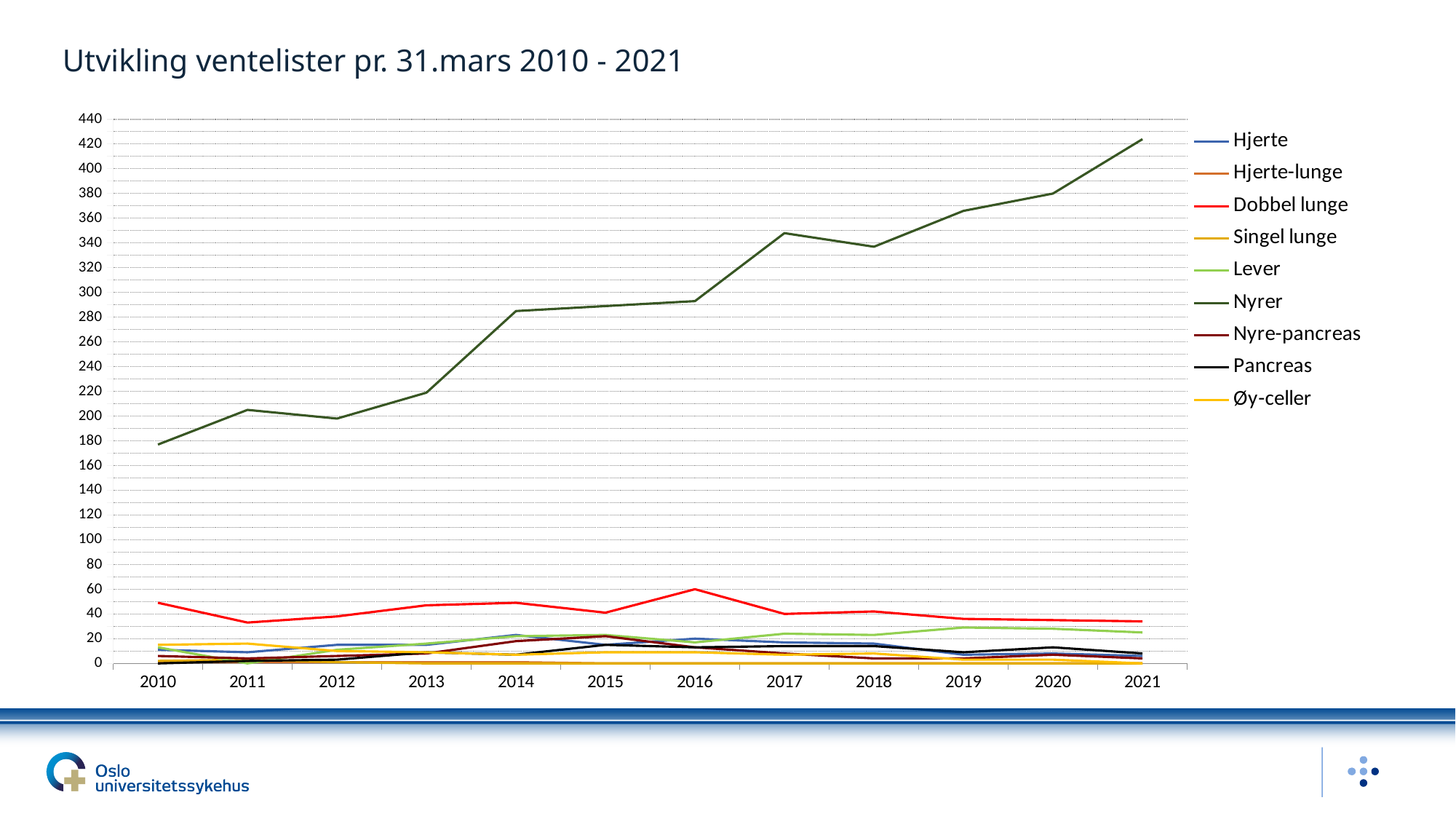
Is the value for Nyrer in 2010 greater or less than 200? less In which year is the Nyrer series at its lowest value? 2010 How many years are shown along the x axis? 12 What is the title of the chart? Utvikling ventelister pr. 31.mars 2010 - 2021 Does the Nyrer series generally rise or fall from 2010 to 2021? rise In which year does the Nyrer series reach its highest value? 2021 Which is larger in 2021, the value for Nyrer or the value for Dobbel lunge? Nyrer Which series has the highest values throughout the chart? Nyrer What kind of chart is shown on the slide? line chart How many series does the legend list? 9 Is the value for Dobbel lunge in 2016 greater or less than 40? greater Is the value for Nyrer in 2021 greater or less than 400? greater